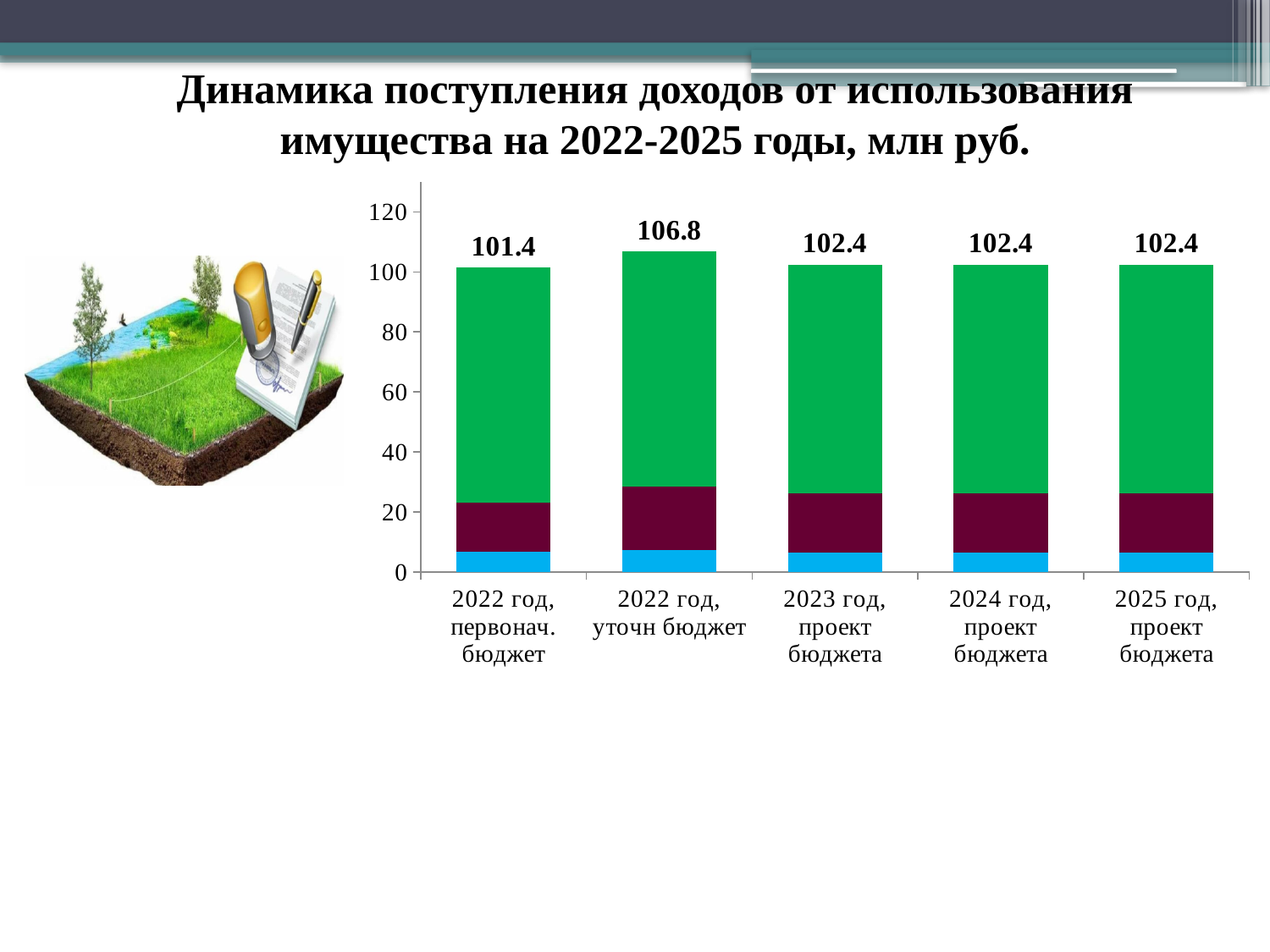
Which category has the lowest total value? 2022 год, первонач. бюджет Is the total value for "2025 год, проект бюджета" greater or less than 100? greater Which is larger: the total for "2023 год, проект бюджета" or the total for "2022 год, первонач. бюджет"? 2023 год, проект бюджета What is the total value labelled on the bar for "2024 год, проект бюджета"? 102.4 How many categories are shown on the x axis? 5 What kind of chart is shown on the slide? Stacked bar chart How many coloured segments does each bar consist of? 3 Which category has the highest total value? 2022 год, уточн бюджет What is the difference between the total for "2022 год, уточн бюджет" and the total for "2022 год, первонач. бюджет"? 5.4 What is the total value labelled on the bar for "2022 год, уточн бюджет"? 106.8 Do the total values change between "2023 год, проект бюджета" and "2025 год, проект бюджета"? No, they stay at 102.4 What is the total value labelled on the bar for "2022 год, первонач. бюджет"? 101.4